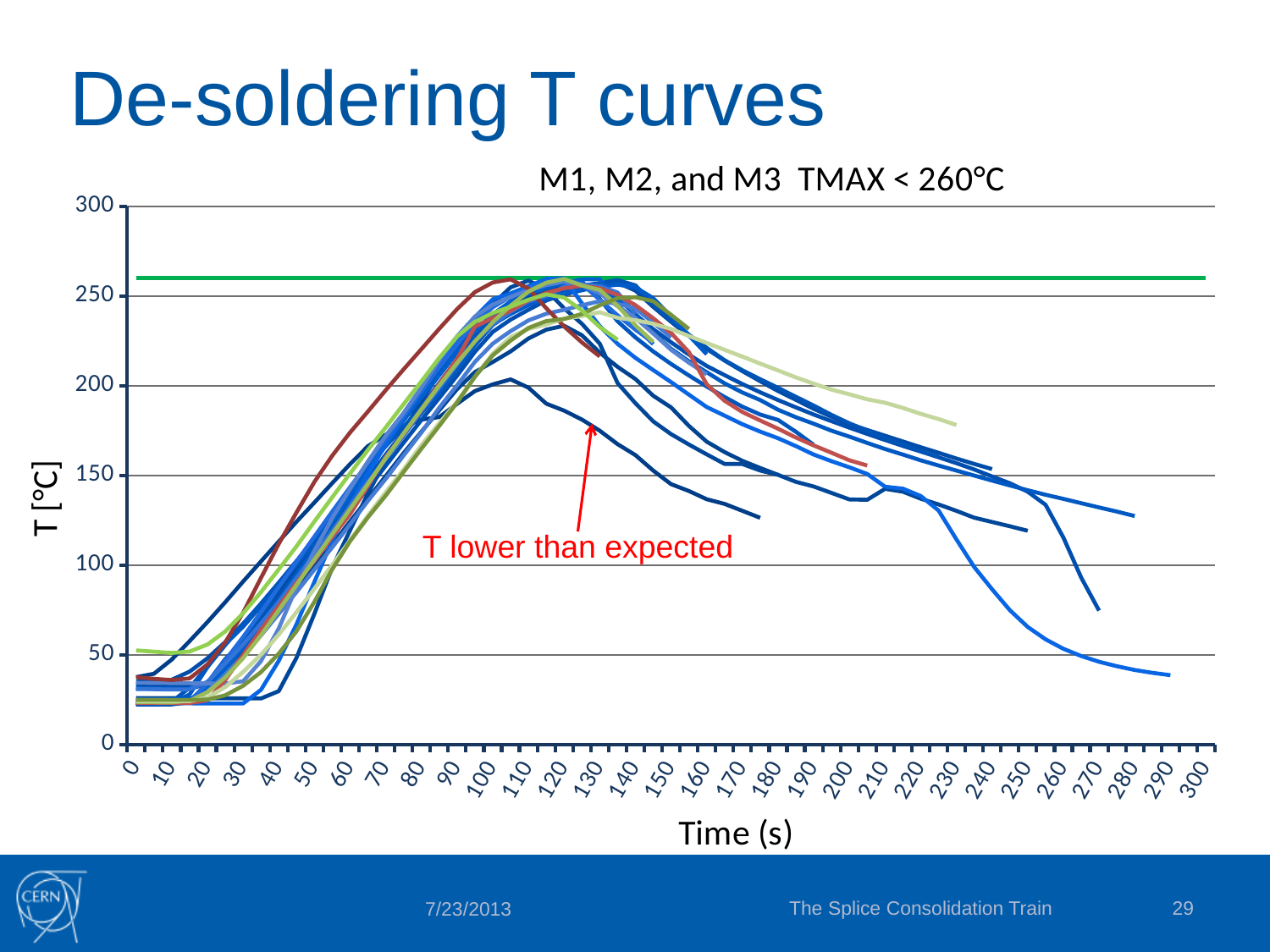
Is the peak of the curve marked 'T lower than expected' greater or less than 150 °C? greater Do the temperature curves rise or fall between 0 s and 100 s? rise Do any of the temperature curves in the chart rise above the 260 °C limit line? No What kind of chart is shown on the slide? line chart What is the highest value shown on the vertical axis of the chart? 300 Is the horizontal green limit line in the chart greater or less than 250 °C? greater Do the temperature curves rise or fall between 150 s and 250 s? fall What is the largest time value shown on the horizontal axis of the chart? 300 What is the label of the horizontal axis of the chart? Time (s) What is the label of the vertical axis of the chart? T [°C] What is the title of the chart? M1, M2, and M3 TMAX < 260°C